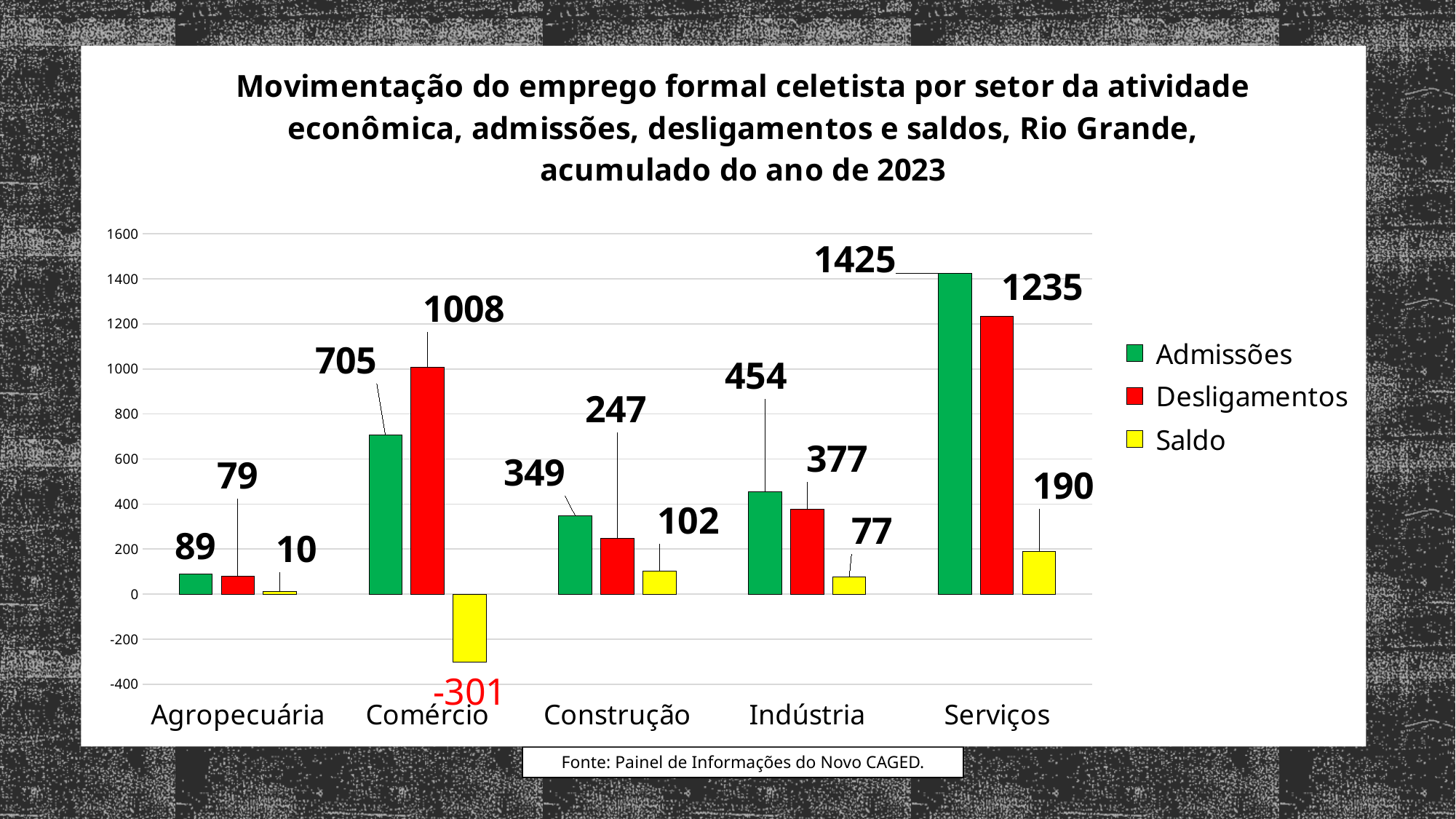
What is the difference between Admissões and Desligamentos for Serviços? 190 What kind of chart is shown on the slide? bar chart Which sector has the lowest Saldo value? Comércio What is the Admissões value for Comércio? 705 Which sector has the highest Admissões value? Serviços What is the Saldo value for Comércio? -301 Is the Desligamentos value for Serviços greater or less than 1200? greater How many sectors are shown on the x axis? 5 What colour represents the Saldo series in the legend? yellow Which is larger for Comércio: Admissões or Desligamentos? Desligamentos What is the Desligamentos value for Indústria? 377 How many series does the legend list? 3